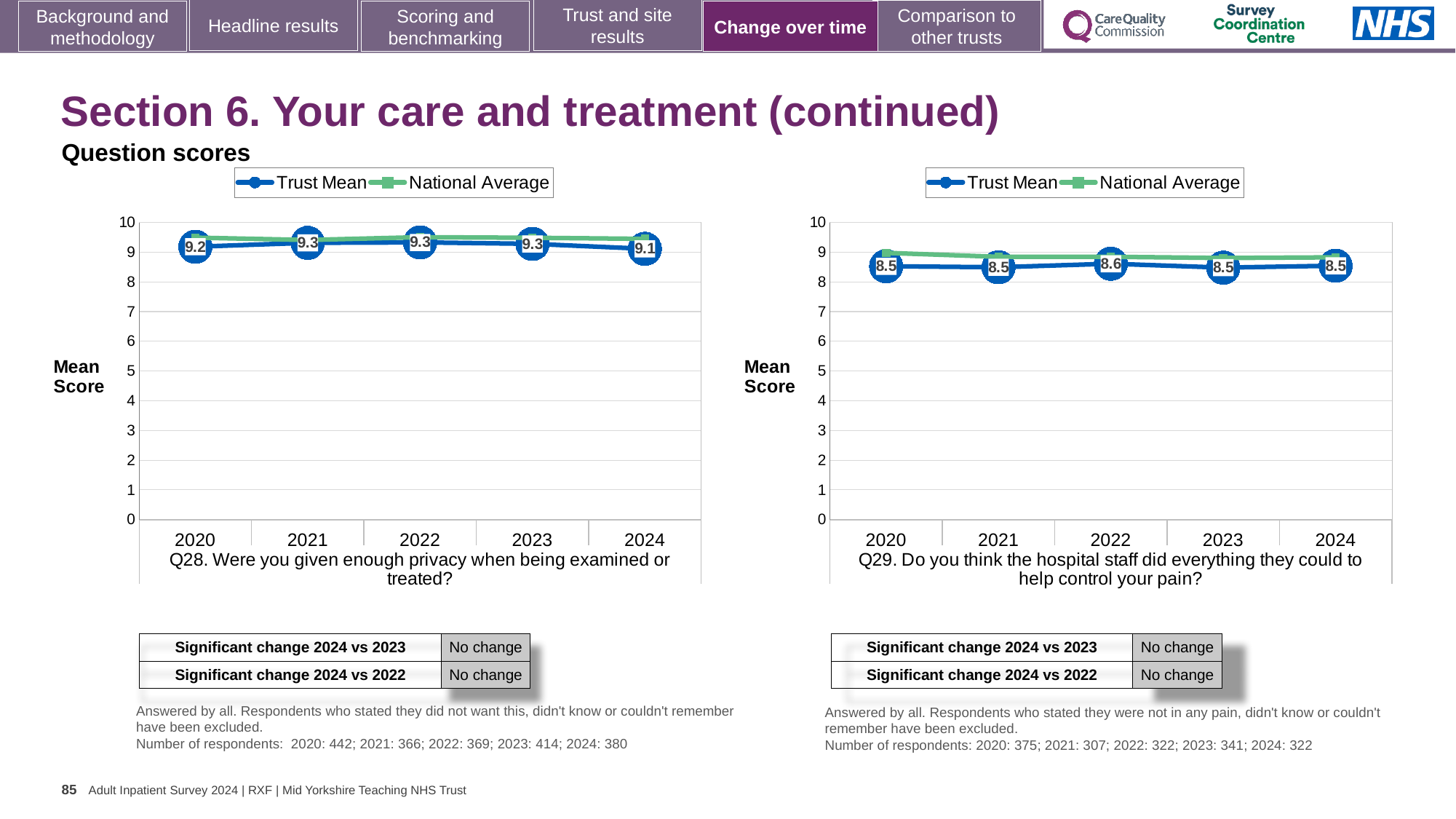
In the Q28 chart (left), which year has the lowest Trust Mean score? 2024 Is the Trust Mean score for 2021 in the Q28 chart (left) larger than the Trust Mean score for 2021 in the Q29 chart (right)? Yes, 9.3 vs 8.5 In the Q28 chart (left), what is the Trust Mean score for 2020? 9.2 In the Q29 chart (right), what is the Trust Mean score for 2022? 8.6 In the Q28 chart (left), what is the difference between the Trust Mean score in 2023 and in 2024? 0.2 In the Q28 chart (left), does the Trust Mean score rise or fall from 2023 to 2024? Fall What kind of chart is used for Q29 (right)? Line chart In the Q28 chart (left), is the National Average value for 2020 greater or less than 9? greater How many years are plotted on the x axis of the Q29 chart (right)? 5 How many series does the legend of the Q28 chart (left) list? 2 In the Q29 chart (right), which year has the highest Trust Mean score? 2022 In the Q28 chart (left), what is the Trust Mean score for 2024? 9.1